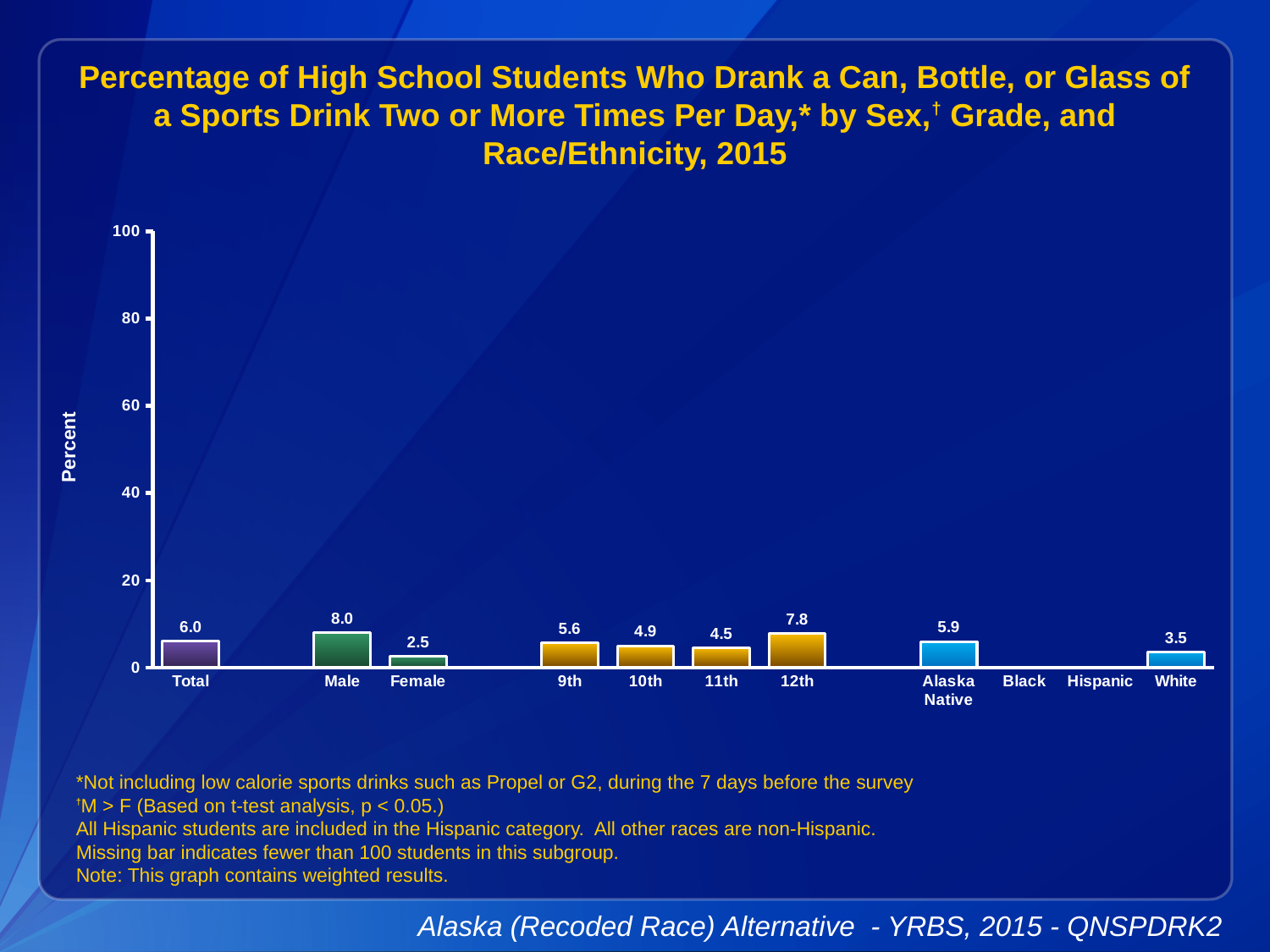
What is the value for Male? 8.0 What is the value for Female? 2.5 What is the value for Alaska Native? 5.9 What is the value for 12th grade? 7.8 Which is larger, the value for 9th grade or 11th grade? 9th Which category with a bar has the lowest value? Female How many categories have a bar shown? 9 Which categories have no bar shown? Black and Hispanic Is the value for Total greater or less than 20? less What kind of chart is this? bar chart Which category has the highest value? Male What is the difference between the Male and Female values? 5.5